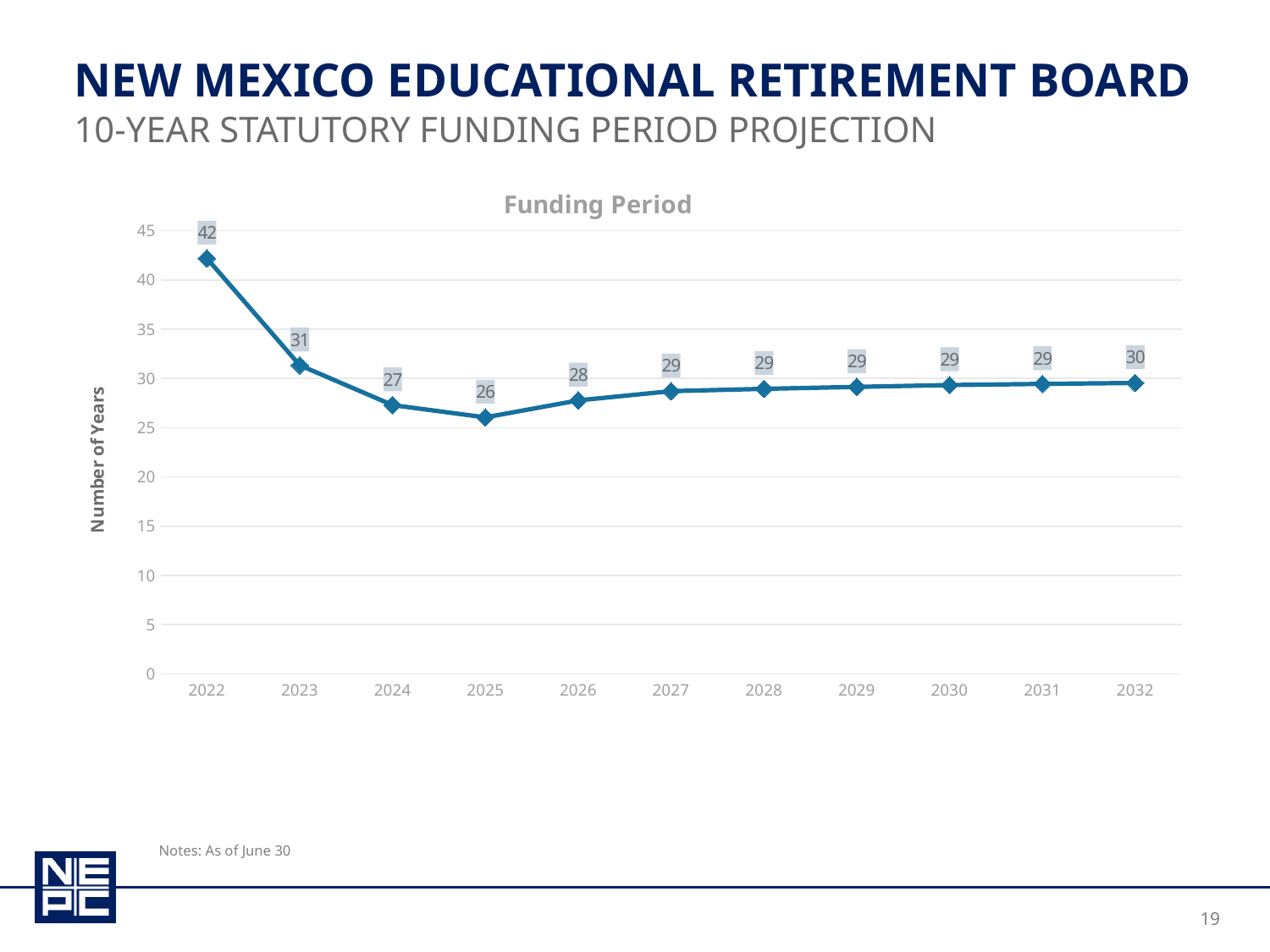
What is the funding period value for 2025? 26 Is the funding period value for 2024 greater or less than 30? less Which year has the highest funding period value? 2022 Which is larger, the funding period value for 2023 or for 2026? 2023 Does the funding period value rise or fall from 2022 to 2025? fall How many years are plotted on the chart? 11 What kind of chart is shown on the slide? line chart Which year has the lowest funding period value? 2025 What is the difference between the funding period values for 2022 and 2023? 11 What is the title of the chart? Funding Period What is the funding period value for 2022? 42 What is the funding period value for 2032? 30